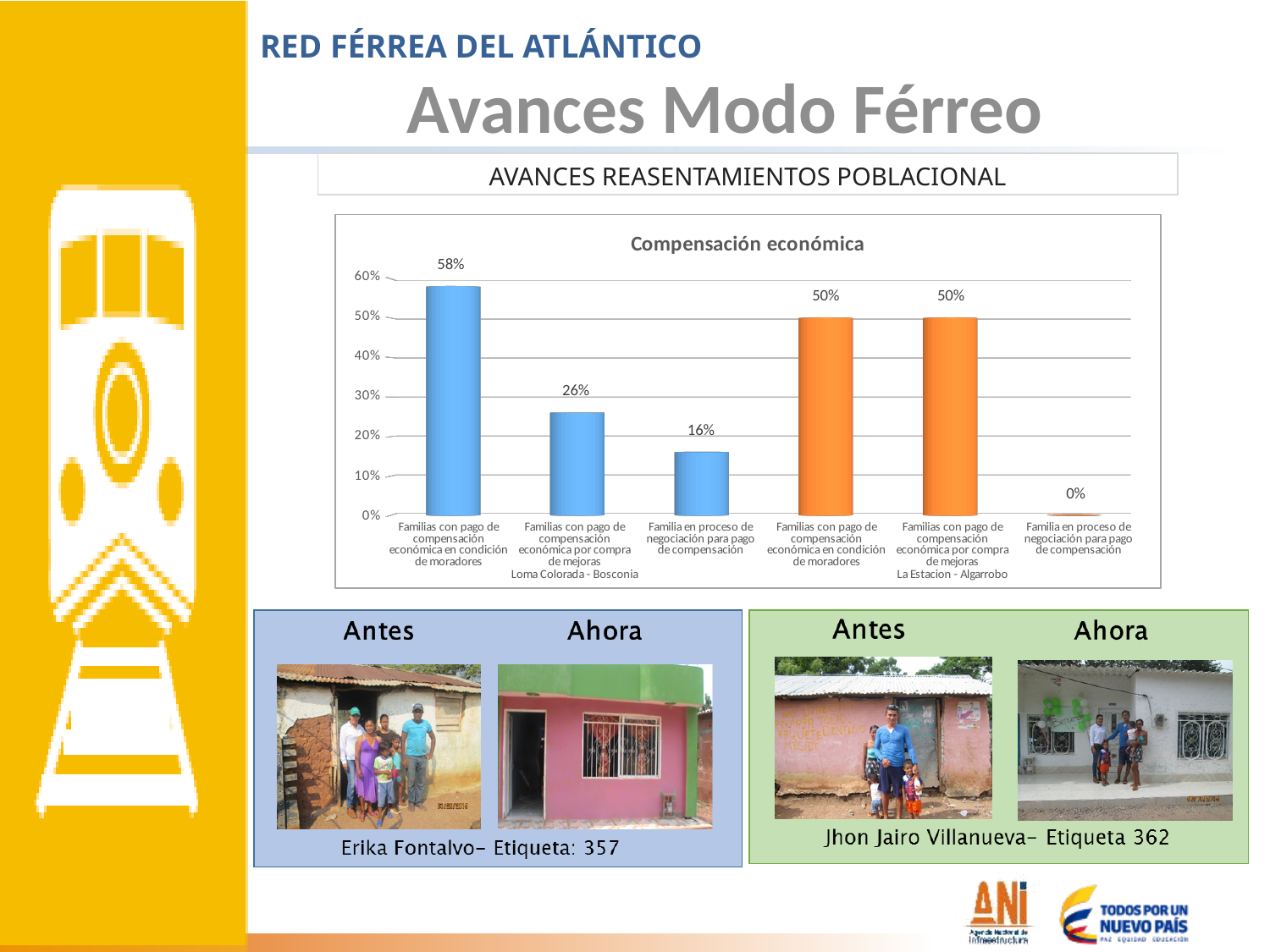
What is the value for "Familia en proceso de negociación para pago de compensación" in Loma Colorada - Bosconia? 16% Which is larger: the value for "Familias con pago de compensación económica por compra de mejoras" in Loma Colorada - Bosconia or in La Estacion - Algarrobo? La Estacion - Algarrobo How many bars are plotted in the "Compensación económica" chart? 6 What is the value for "Familia en proceso de negociación para pago de compensación" in La Estacion - Algarrobo? 0% What is the difference between the value for families paid in condition of moradores in Loma Colorada - Bosconia (58%) and the same category in La Estacion - Algarrobo (50%)? 8% What is the title of the chart on the slide? Compensación económica Which category has the highest value in the "Compensación económica" chart? Familias con pago de compensación económica en condición de moradores (Loma Colorada - Bosconia) What colour are the bars for La Estacion - Algarrobo in the "Compensación económica" chart? orange What is the value for "Familias con pago de compensación económica por compra de mejoras" in Loma Colorada - Bosconia? 26% What is the value for "Familias con pago de compensación económica en condición de moradores" in Loma Colorada - Bosconia? 58% What type of chart is shown under "Compensación económica"? bar chart Which category has the lowest value in the "Compensación económica" chart? Familia en proceso de negociación para pago de compensación (La Estacion - Algarrobo)